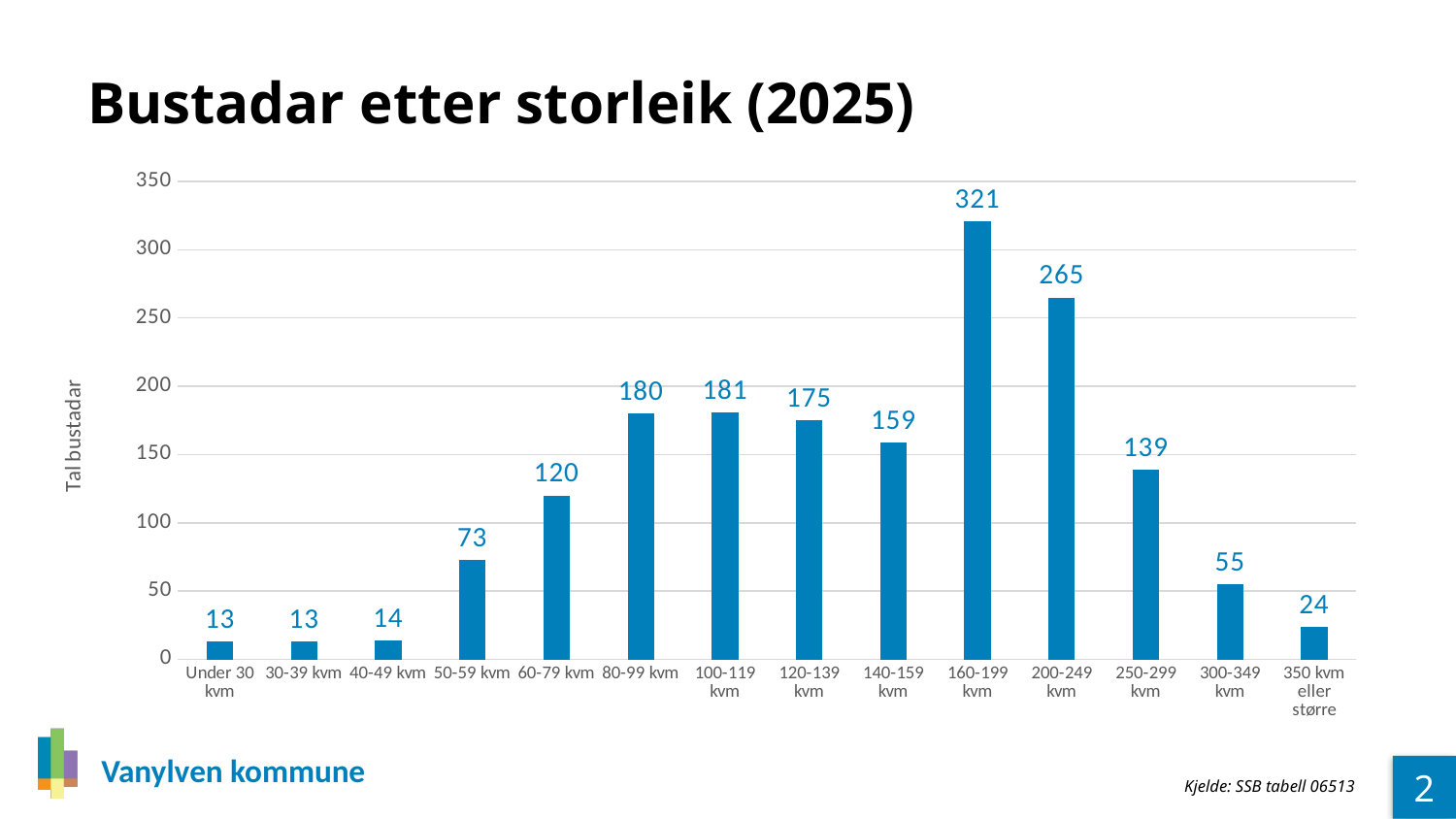
What is the value for the 160-199 kvm category? 321 How many dwellings are shown for the 50-59 kvm category? 73 Which is larger, the value for 120-139 kvm or the value for 140-159 kvm? 120-139 kvm What is the difference between the values for 80-99 kvm and 60-79 kvm? 60 What is the value for the '350 kvm eller større' category? 24 What is the title of the chart? Bustadar etter storleik (2025) Which category has the highest value? 160-199 kvm What is the difference between the values for 160-199 kvm and 200-249 kvm? 56 How many size categories are shown on the x axis? 14 What kind of chart is shown on the slide? Bar chart Is the value for 250-299 kvm greater or less than 150? less What is the label on the vertical axis? Tal bustadar